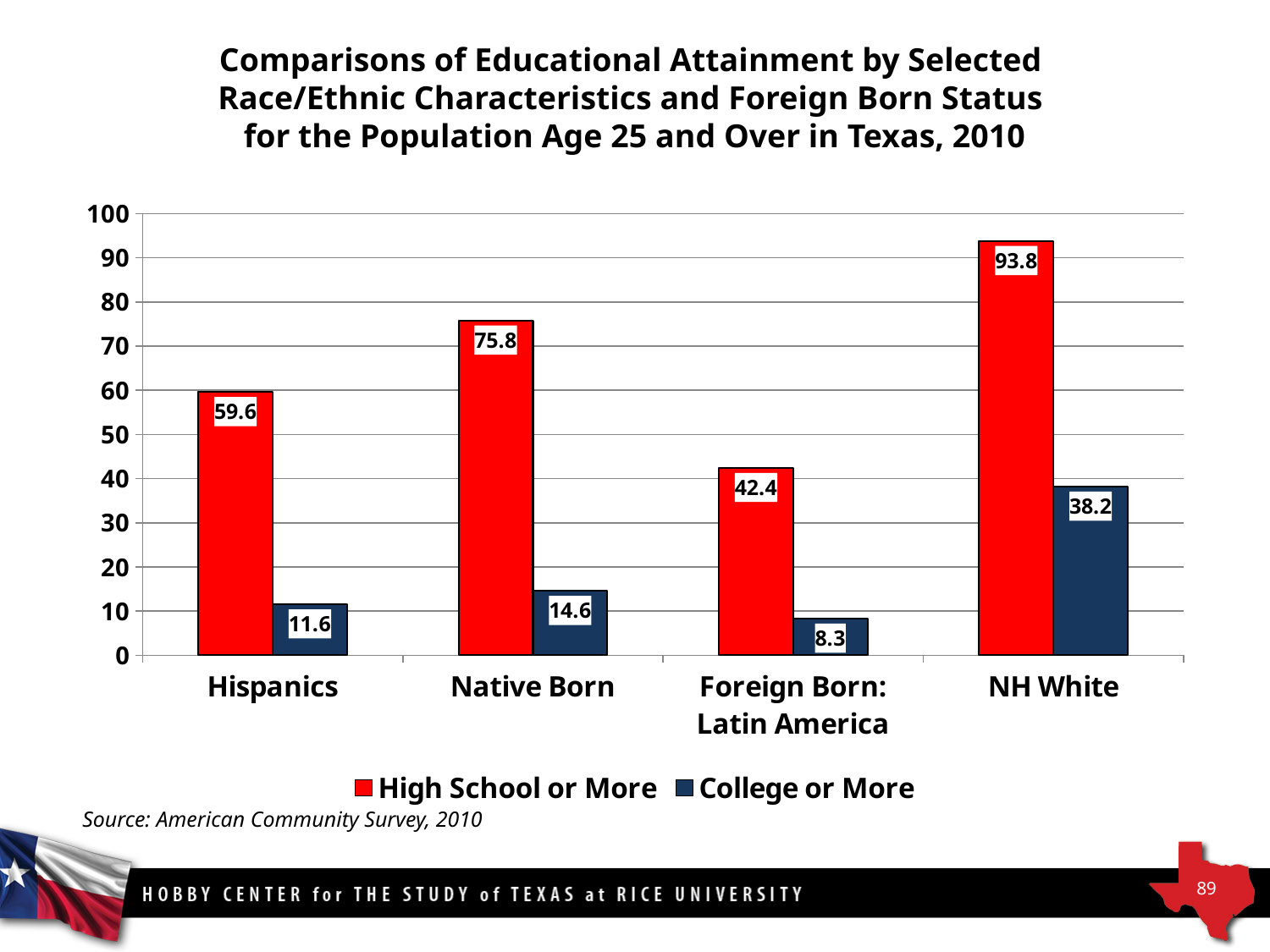
How many series does the legend list? 2 What is the College or More value for NH White? 38.2 What is the College or More value for Foreign Born: Latin America? 8.3 Which category has the highest High School or More value? NH White What is the difference between the High School or More and College or More values for Native Born? 61.2 How many categories are shown on the x axis? 4 What colour represents the College or More series? dark blue Which is larger: the College or More value for Hispanics or for Native Born? Native Born Which category has the lowest College or More value? Foreign Born: Latin America What kind of chart is shown on the slide? bar chart What is the High School or More value for Hispanics? 59.6 Is the High School or More value for Foreign Born: Latin America greater or less than 50? less